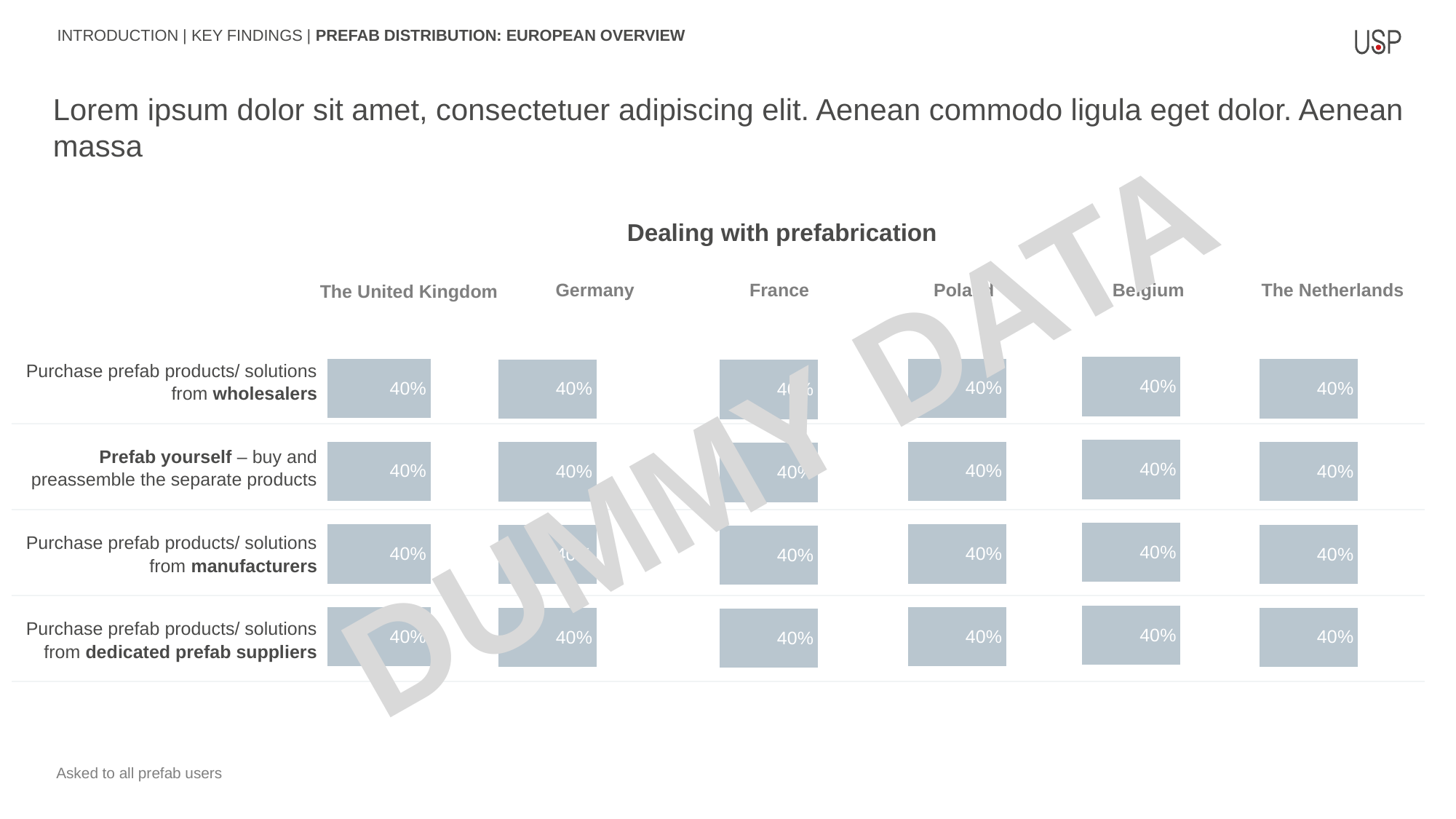
In the chart for The Netherlands, what is the difference between the value for 'from wholesalers' and the value for 'from manufacturers'? 0% In the chart for France, what is the value for 'Purchase prefab products/ solutions from dedicated prefab suppliers'? 40% What kind of chart is used for each country on this slide? Bar chart In the chart for Belgium, what is the value for 'Purchase prefab products/ solutions from manufacturers'? 40% In the chart for The United Kingdom, which is larger: the value for 'from wholesalers' or the value for 'from manufacturers'? They are equal (both 40%) In the chart for Germany, what is the value for 'Prefab yourself – buy and preassemble the separate products'? 40% In the chart for The United Kingdom, what is the value for 'Purchase prefab products/ solutions from wholesalers'? 40% How many countries have a chart on this slide? 6 In the chart for The Netherlands, what is the value for 'Purchase prefab products/ solutions from dedicated prefab suppliers'? 40% How many categories (rows) are plotted in each country's chart? 4 In the chart for Poland, what is the value for 'Prefab yourself – buy and preassemble the separate products'? 40% What is the title shown above the charts? Dealing with prefabrication